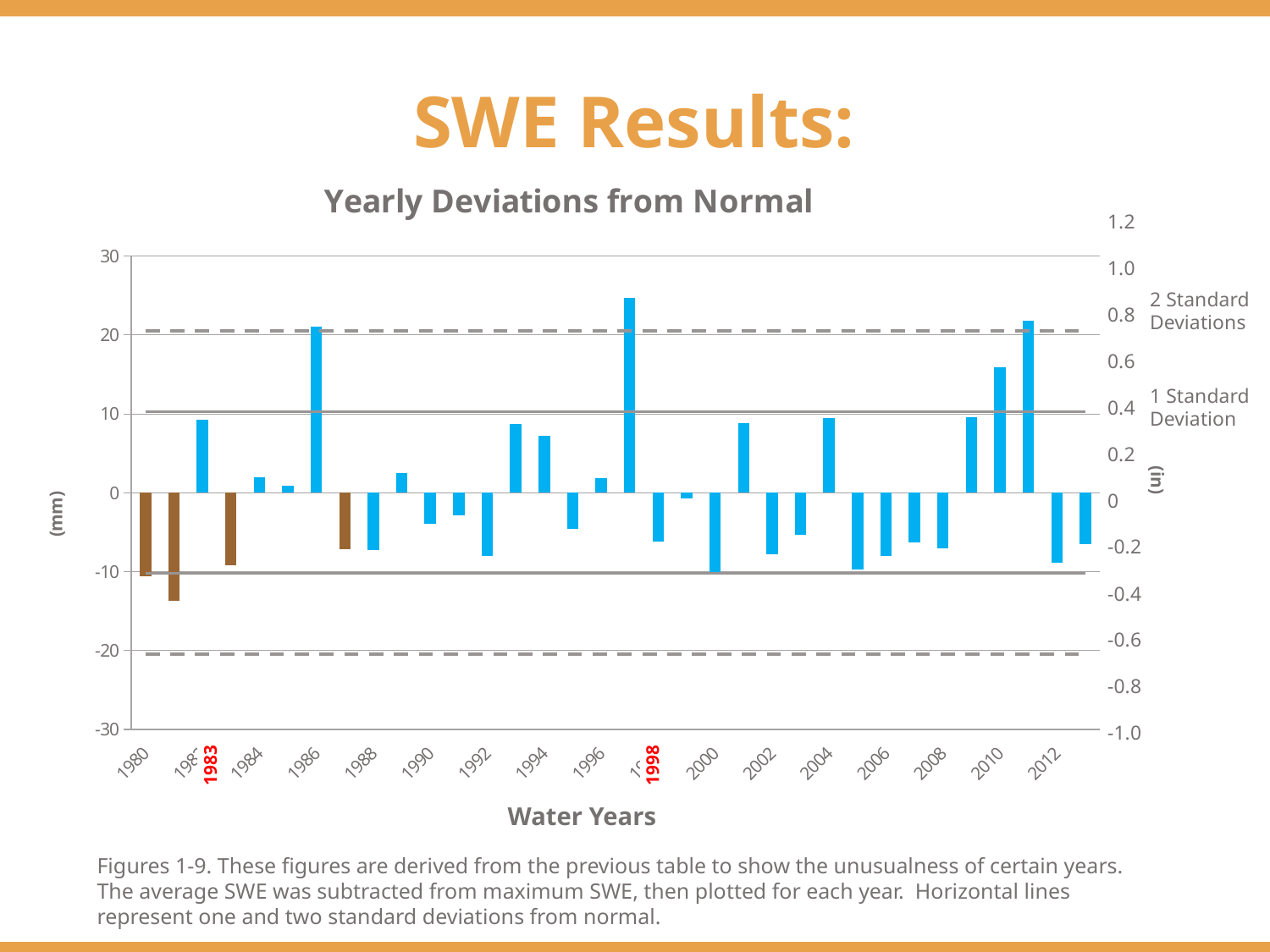
Is the deviation for 1981 greater or less than -10 mm? less Which water year has the larger deviation, 2010 or 2011? 2011 Which water year has the highest deviation from normal? 1997 Which water year has the lowest deviation from normal? 1981 Is the deviation for 2010 greater or less than 10 mm? greater Is the deviation for 2004 greater or less than 0 mm? greater What is the title of the x axis of the chart? Water Years What kind of chart is shown on the slide? Bar chart Which water year has the larger deviation, 1997 or 1986? 1997 What is the title of the chart? Yearly Deviations from Normal